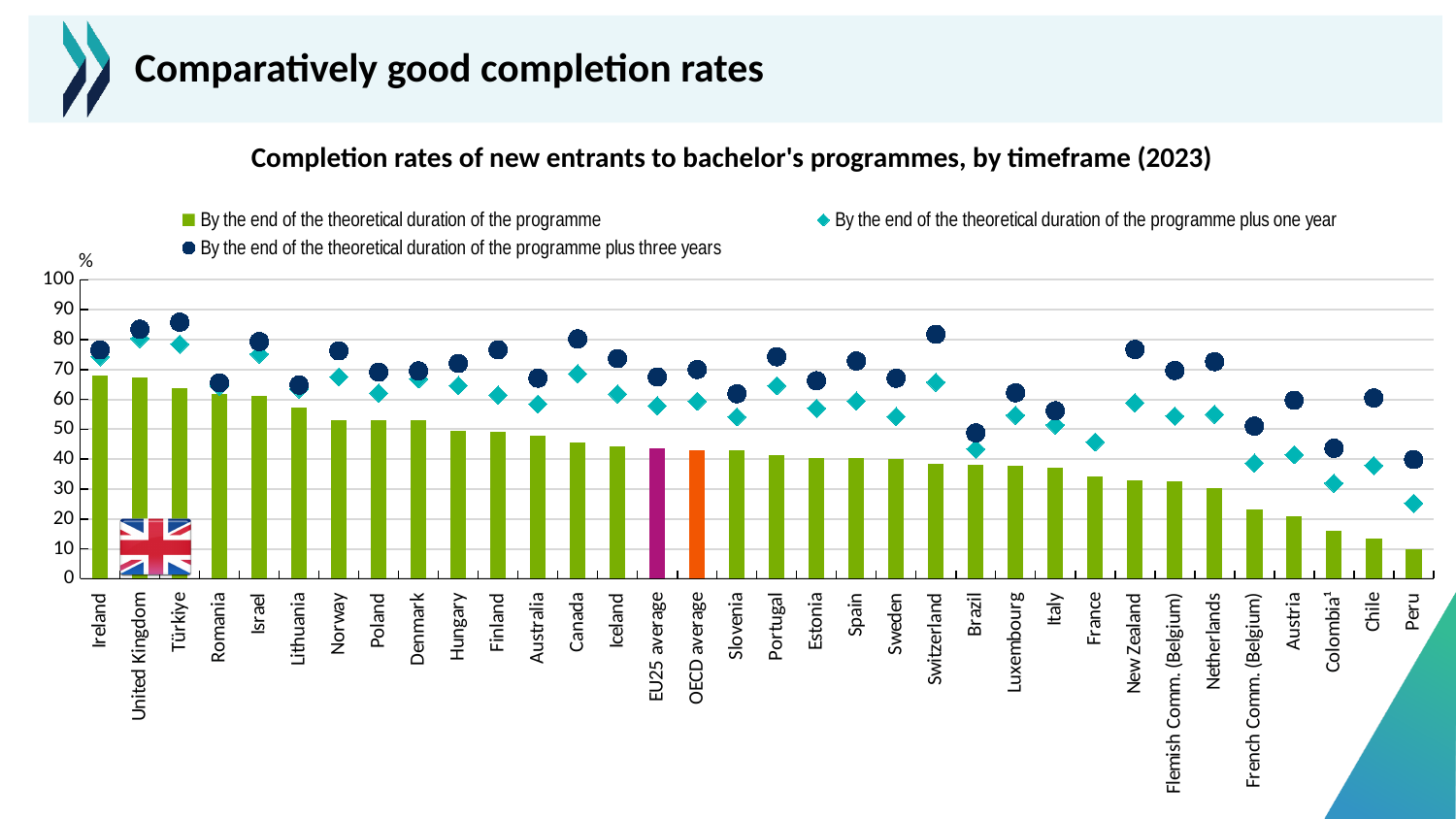
What kind of chart is shown on the slide? bar chart Which country has the highest value for completion by the end of the theoretical duration plus three years? Türkiye Which has the larger bar for completion by the end of the theoretical duration: Ireland or Chile? Ireland Which country has the lowest value for completion by the end of the theoretical duration plus one year? Peru How many series does the legend list? 3 Is the value for Switzerland by the end of the theoretical duration plus three years greater or less than 80? greater Is the bar for Chile (by the end of the theoretical duration) greater or less than 20? less How many countries or averages are shown along the x axis? 34 Which country has the lowest bar for completion by the end of the theoretical duration of the programme? Peru Do the bars for completion by the end of the theoretical duration rise or fall from left to right along the x axis? fall Is the bar for Ireland (by the end of the theoretical duration) greater or less than 60? greater What is the title of the chart? Completion rates of new entrants to bachelor's programmes, by timeframe (2023)